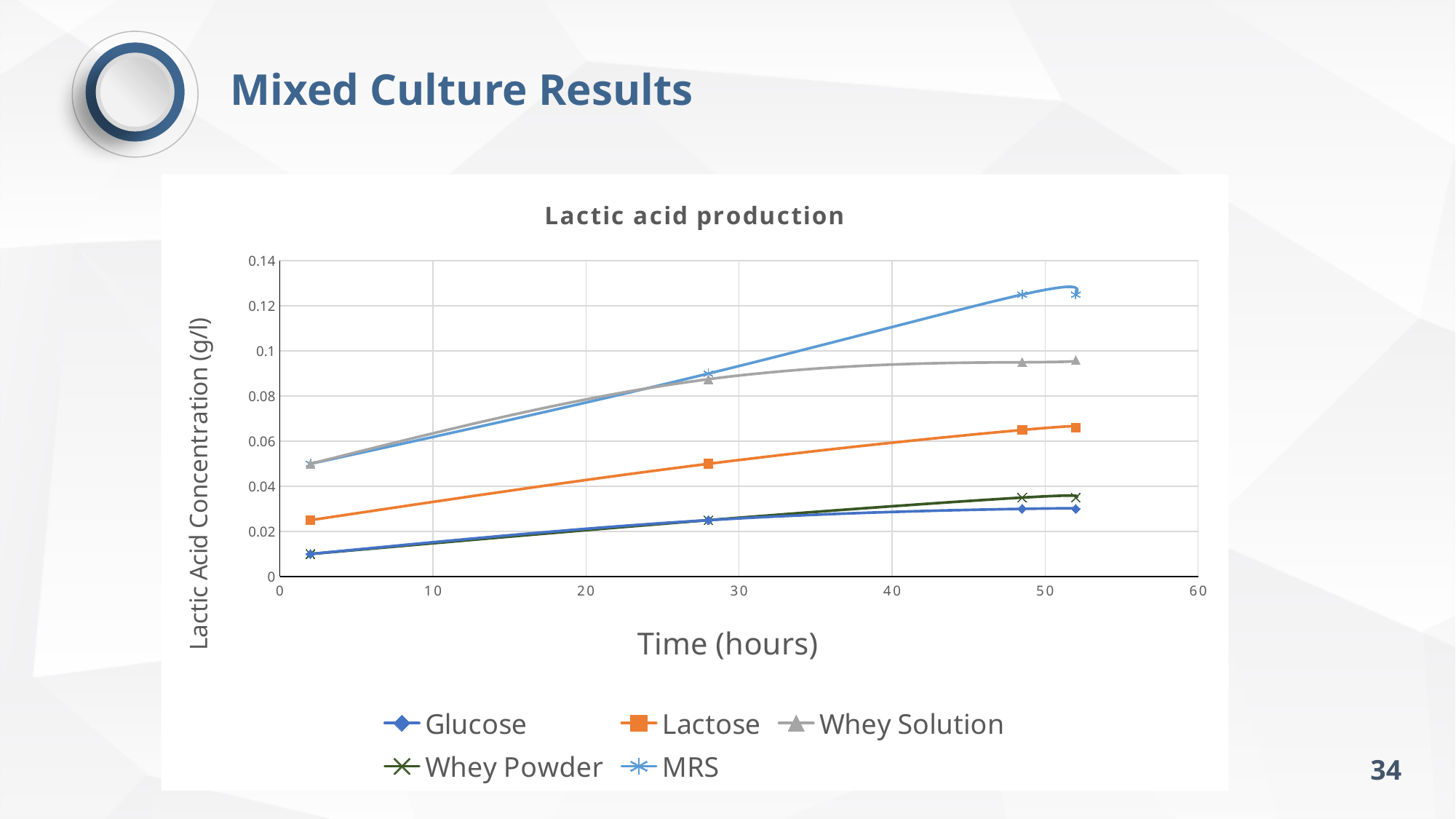
Which series reaches the highest lactic acid concentration at the end of the experiment? MRS Is the value for Whey Solution at around 52 hours greater or less than 0.1? less At around 52 hours, which series has the larger value, MRS or Whey Solution? MRS What kind of chart is shown on the slide? line chart How many series does the legend list? 5 What is the title of the chart? Lactic acid production Is the value for Lactose at around 28 hours greater or less than 0.06? less Is the value for MRS at around 52 hours greater or less than 0.12? greater Does the Lactose series rise or fall as time increases? rise At around 28 hours, which series has the larger value, Lactose or Glucose? Lactose How many data points are plotted for the Lactose series? 4 What is the label of the vertical axis? Lactic Acid Concentration (g/l)